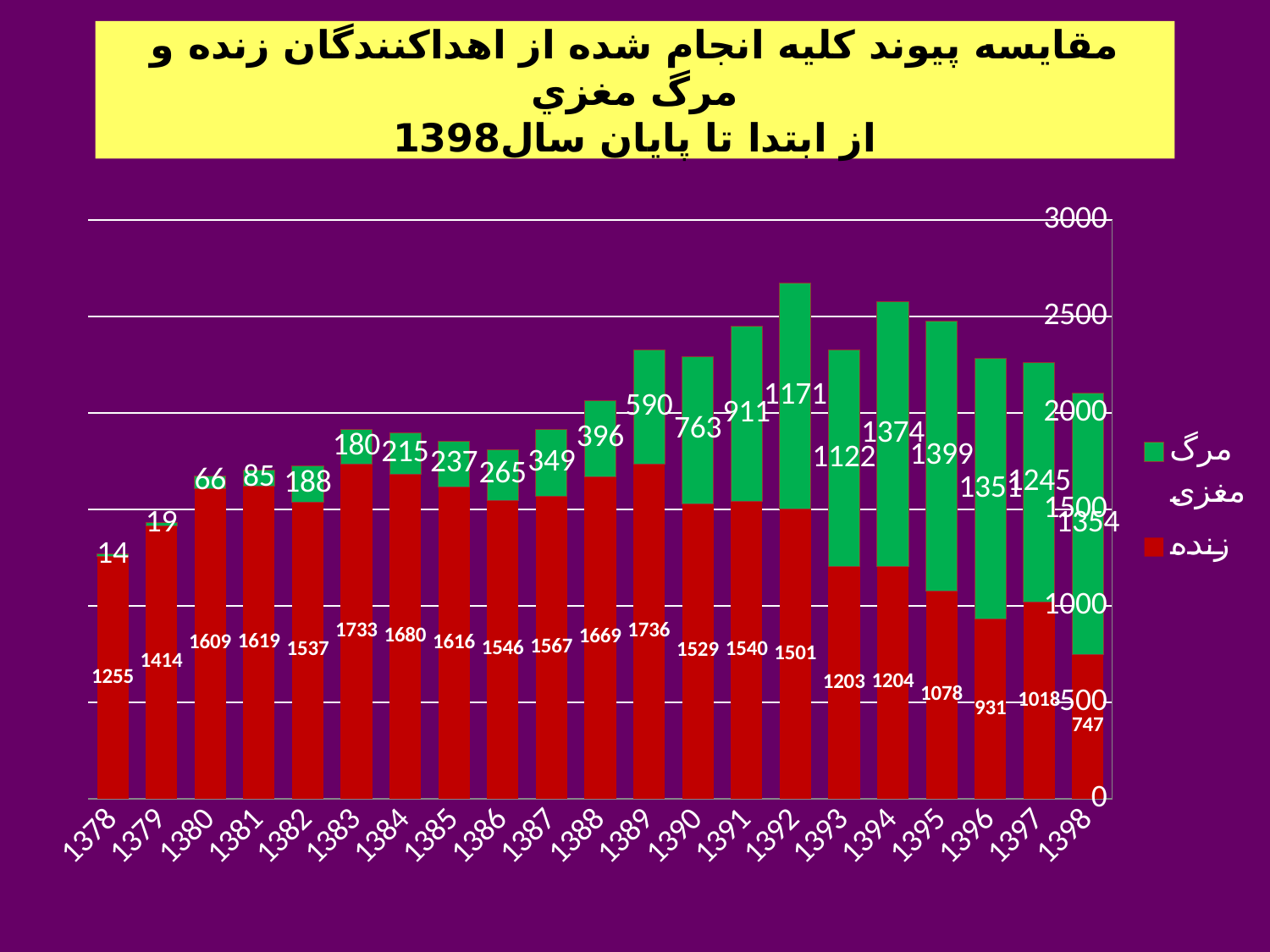
What is the value of the مرگ مغزی (brain death) series for the year 1392? 1171 What is the total height of the stacked bar for the year 1392? 2672 How many years are shown on the x axis? 21 What kind of chart is shown on the slide? Stacked bar chart Which is larger in the year 1398: the زنده value or the مرگ مغزی value? مرگ مغزی In which year is the زنده series lowest? 1398 In which year is the مرگ مغزی series lowest? 1378 What is the value of the زنده (living donor) series for the year 1389? 1736 What is the difference between the زنده value and the مرگ مغزی value in the year 1389? 1146 How many series does the legend list? 2 In which year is the مرگ مغزی series highest? 1395 What is the value of the زنده series for the year 1398? 747